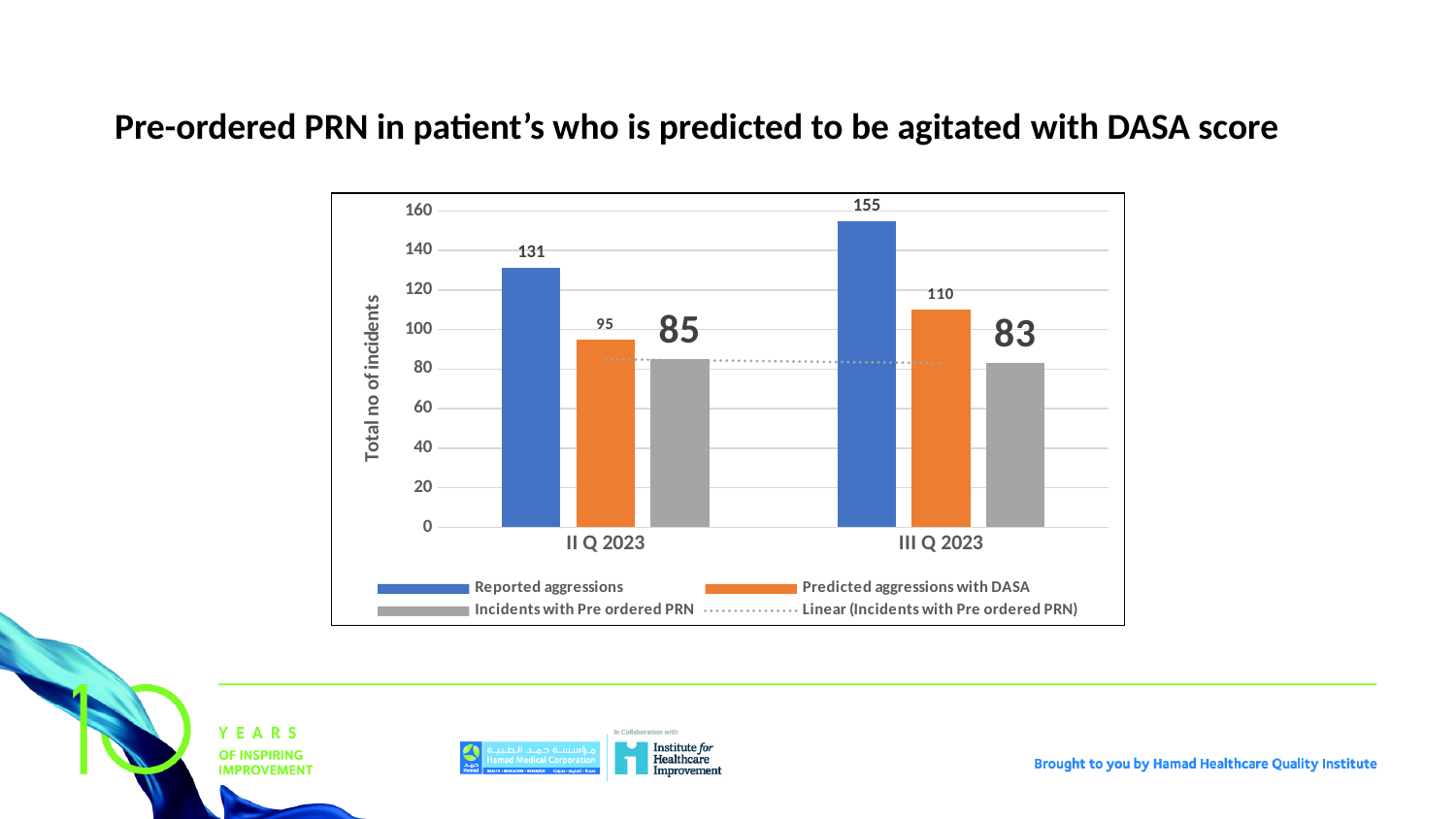
In which quarter is Reported aggressions highest? III Q 2023 What kind of chart is shown on the slide? Bar chart What is the value of Incidents with Pre ordered PRN in III Q 2023? 83 What is the value of Predicted aggressions with DASA in III Q 2023? 110 What is the difference between Reported aggressions and Predicted aggressions with DASA in II Q 2023? 36 What is the value of Incidents with Pre ordered PRN in II Q 2023? 85 How many entries does the legend list? 4 What is the value of Reported aggressions in II Q 2023? 131 How many quarters are shown on the x axis? 2 What is the difference between Reported aggressions in III Q 2023 and II Q 2023? 24 Which is larger in III Q 2023: Predicted aggressions with DASA or Incidents with Pre ordered PRN? Predicted aggressions with DASA What is the label of the y axis? Total no of incidents